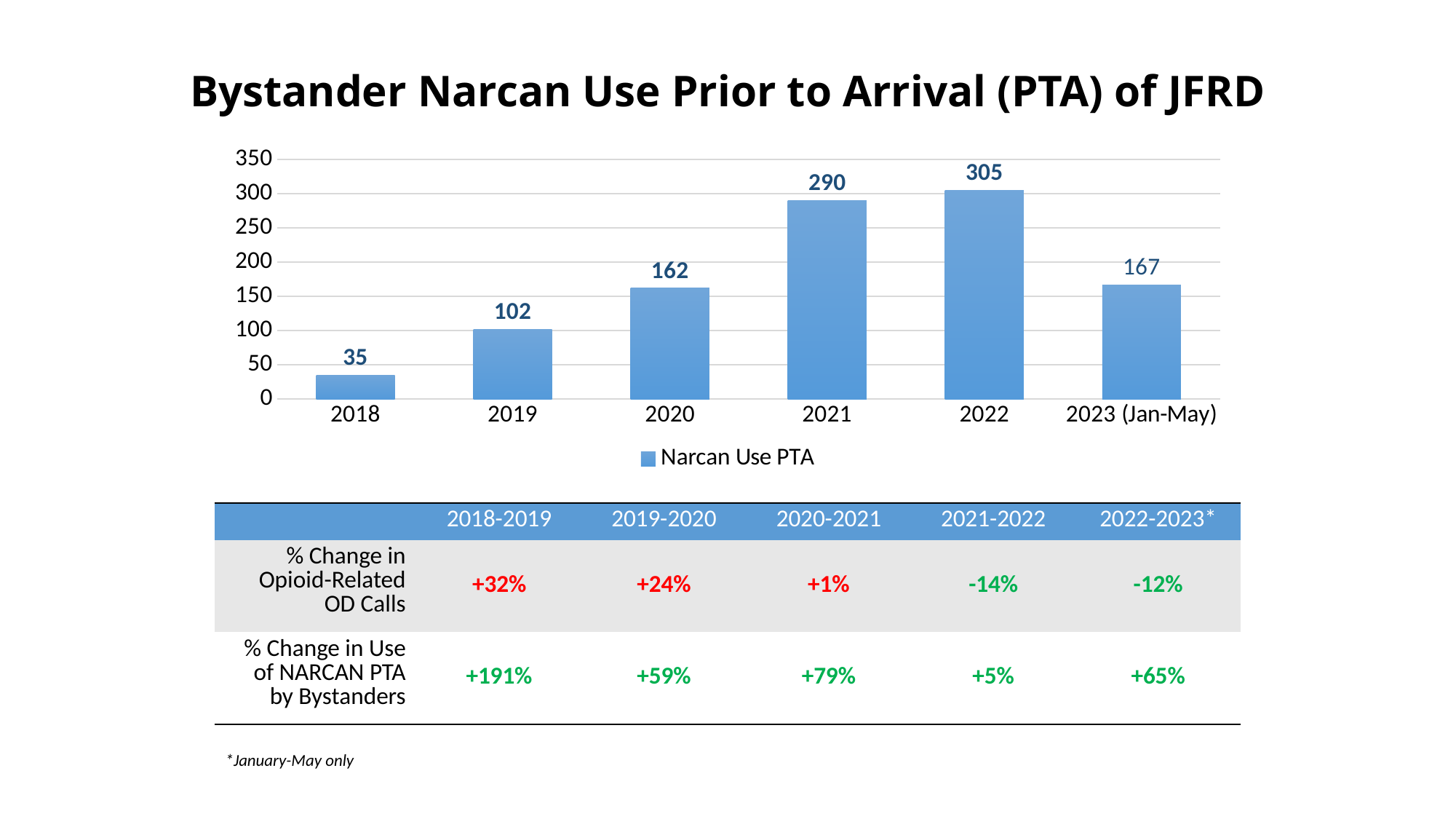
How many categories are shown on the x axis of the chart? 6 What is the title of the chart? Bystander Narcan Use Prior to Arrival (PTA) of JFRD Which is larger, the Narcan Use PTA value for 2020 or for 2023 (Jan-May)? 2023 (Jan-May) What is the difference between the Narcan Use PTA values for 2020 and 2019? 60 What kind of chart is shown on the slide? Bar chart How many series does the chart legend list? 1 What is the difference between the Narcan Use PTA values for 2022 and 2021? 15 What is the Narcan Use PTA value for 2021? 290 What is the Narcan Use PTA value for 2023 (Jan-May)? 167 What is the Narcan Use PTA value for 2018? 35 Which year has the lowest Narcan Use PTA value? 2018 Which year has the highest Narcan Use PTA value? 2022